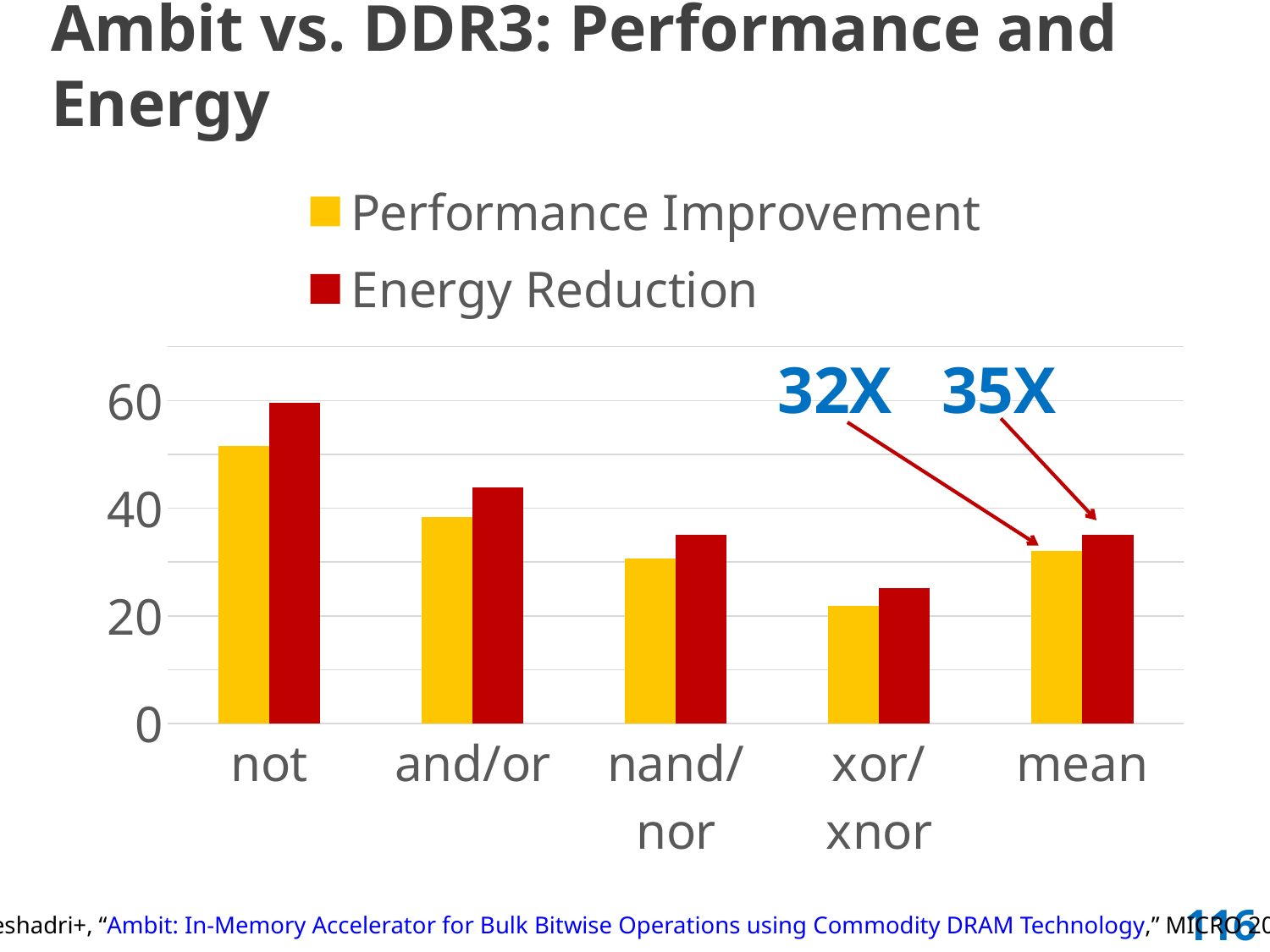
What kind of chart is shown on the slide? bar chart For the not category, which is larger: Performance Improvement or Energy Reduction? Energy Reduction Is the Energy Reduction value for xor/xnor greater or less than 40? less How many categories are shown along the x axis? 5 Which colour represents Energy Reduction in the legend? red Which category has the lowest Performance Improvement? xor/xnor What is the Performance Improvement value for the mean category? 32X Is the Performance Improvement value for not greater or less than 40? greater What is the difference between the Energy Reduction and Performance Improvement values for the mean category? 3X How many series does the legend list? 2 Which category has the highest Energy Reduction? not What is the Energy Reduction value for the mean category? 35X